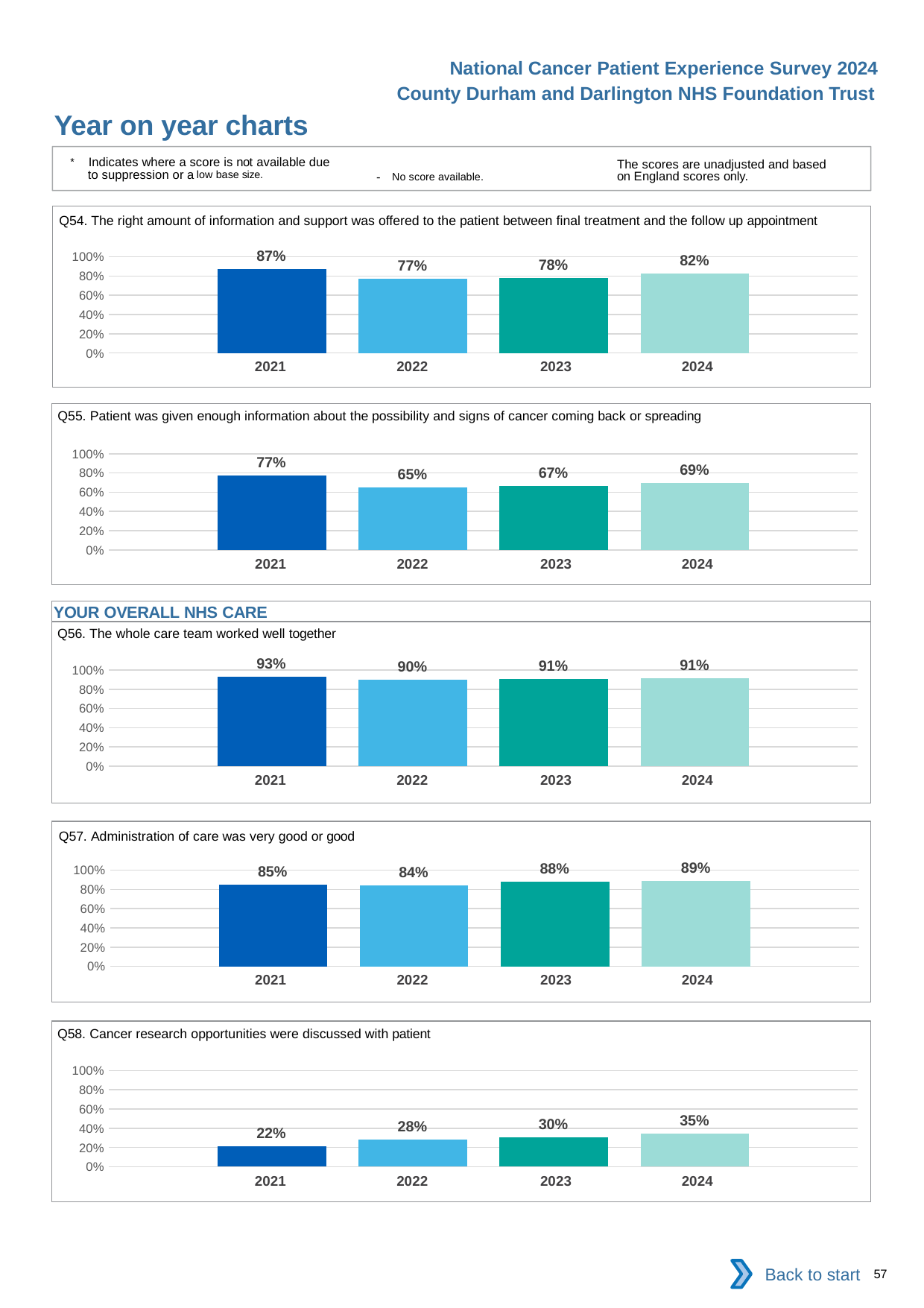
What kind of chart is the Q57 chart? bar chart In the Q57 chart, what is the difference between the 2024 and 2022 values? 5% In the Q54 chart, which is larger, the value for 2022 or the value for 2024? 2024 In the Q56 chart, which year has the highest value? 2021 In the Q58 chart, do the values rise or fall from 2021 to 2024? rise In the Q54 chart, what is the value for 2021? 87% In the Q58 chart, what is the value for 2023? 30% How many years are shown in the Q55 chart? 4 In the Q56 chart, what is the value for 2024? 91% In the Q55 chart, which year has the lowest value? 2022 In the Q55 chart, what is the difference between the 2021 and 2024 values? 8% In the Q58 chart, which year has the highest value? 2024